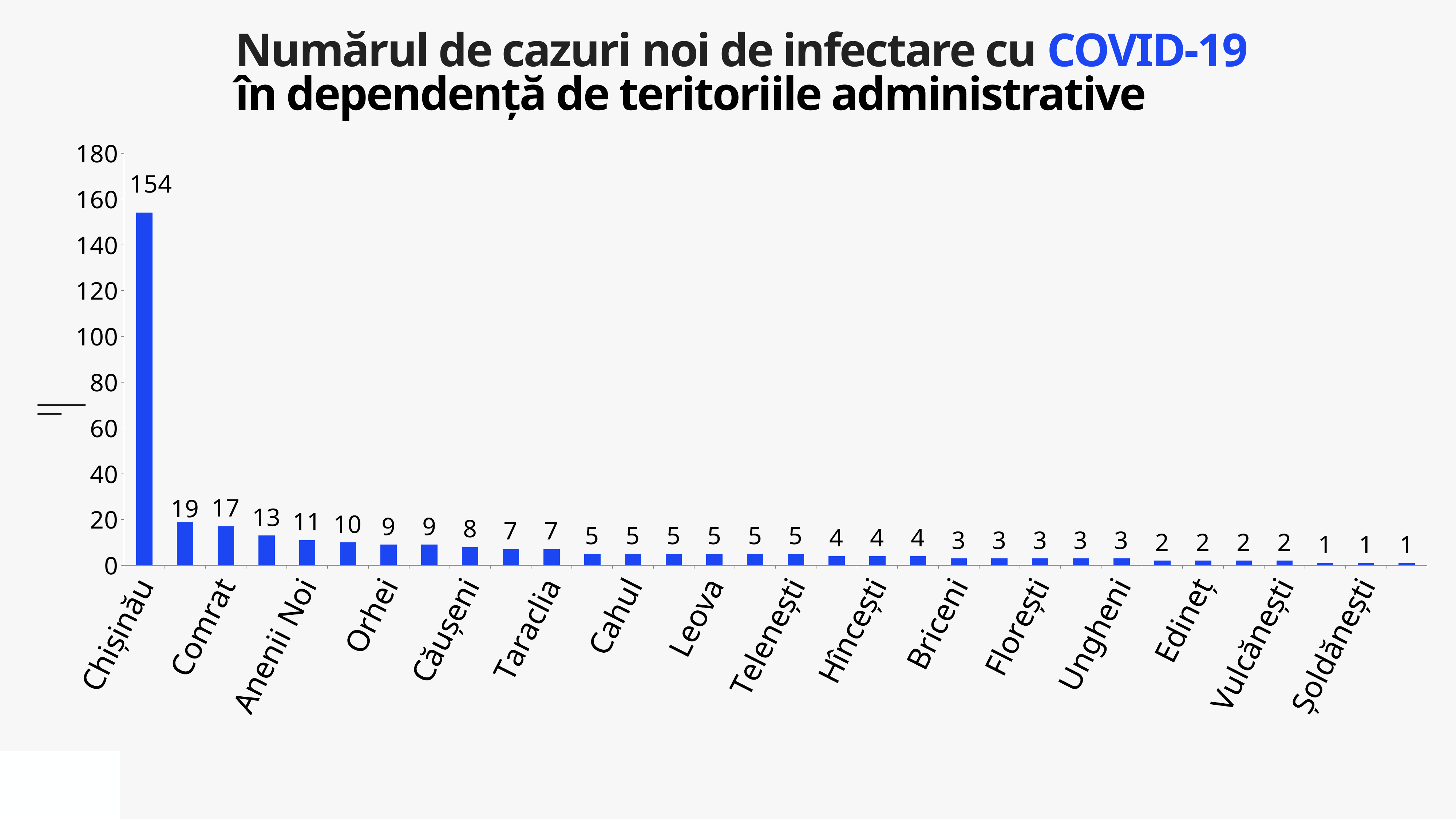
Do the values rise or fall from left to right along the x axis? fall Which administrative territory has the highest number of new cases? Chișinău What is the difference between the values for Chișinău and Comrat? 137 What is the number of new cases for Anenii Noi? 11 Is the value for Chișinău greater or less than 140? greater Which has more new cases, Chișinău or Comrat? Chișinău What is the number of new cases for Comrat? 17 Is the value for Comrat greater or less than 20? less How many bars are plotted in the chart? 32 What type of chart is shown on the slide? bar chart What is the number of new cases for Șoldănești? 1 What is the number of new COVID-19 cases for Chișinău? 154